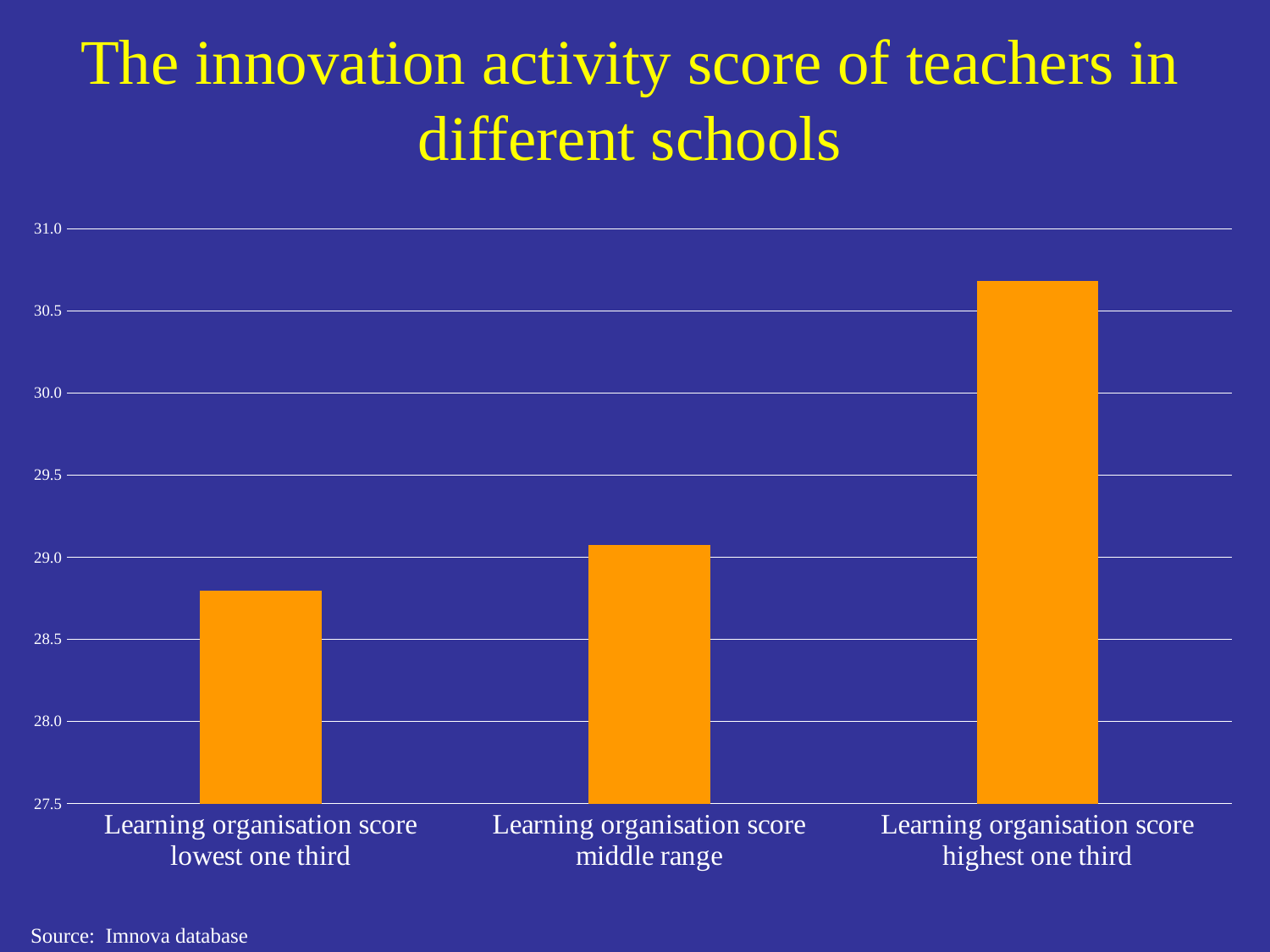
Which category has the highest innovation activity score? Learning organisation score highest one third What source is cited for the chart data? Imnova database Which category has the lowest innovation activity score? Learning organisation score lowest one third Is the value for Learning organisation score lowest one third greater or less than 29.0? less Is the value for Learning organisation score middle range greater or less than 29.5? less How many categories are plotted in the chart? 3 Do the values rise or fall moving from left to right across the categories? rise Is the value for Learning organisation score highest one third greater or less than 30.5? greater What is the title of the chart on the slide? The innovation activity score of teachers in different schools Which is larger, the value for Learning organisation score middle range or for Learning organisation score lowest one third? Learning organisation score middle range What kind of chart is shown on the slide? bar chart